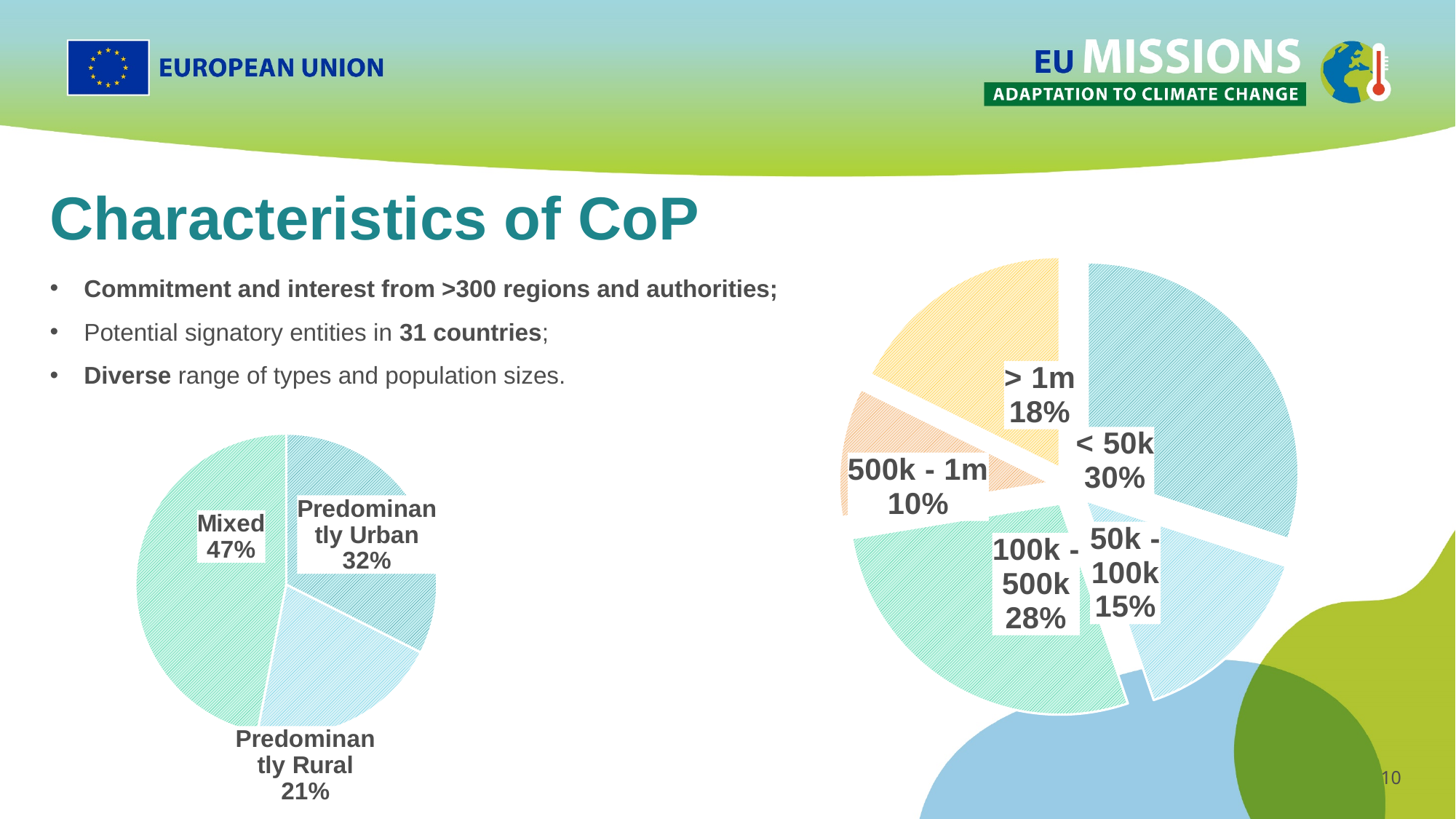
In the pie chart on the left of the slide, which category has the largest share? Mixed In the pie chart on the left of the slide, what share is labelled Mixed? 47% In the pie chart on the right of the slide, which is larger: the share for 100k - 500k or the share for > 1m? 100k - 500k In the pie chart on the left of the slide, what is the difference in percentage points between Predominantly Urban and Predominantly Rural? 11 In the pie chart on the right of the slide, which population size category has the smallest share? 500k - 1m In the pie chart on the right of the slide, what share is labelled 500k - 1m? 10% What kind of chart is shown on the right of the slide? Pie chart In the pie chart on the left of the slide, what share is labelled Predominantly Rural? 21% In the pie chart on the right of the slide, what share is labelled < 50k? 30% In the pie chart on the right of the slide, how many population size categories are shown? 5 In the pie chart on the right of the slide, what is the difference in percentage points between < 50k and 50k - 100k? 15 In the pie chart on the left of the slide, how many slices are there? 3